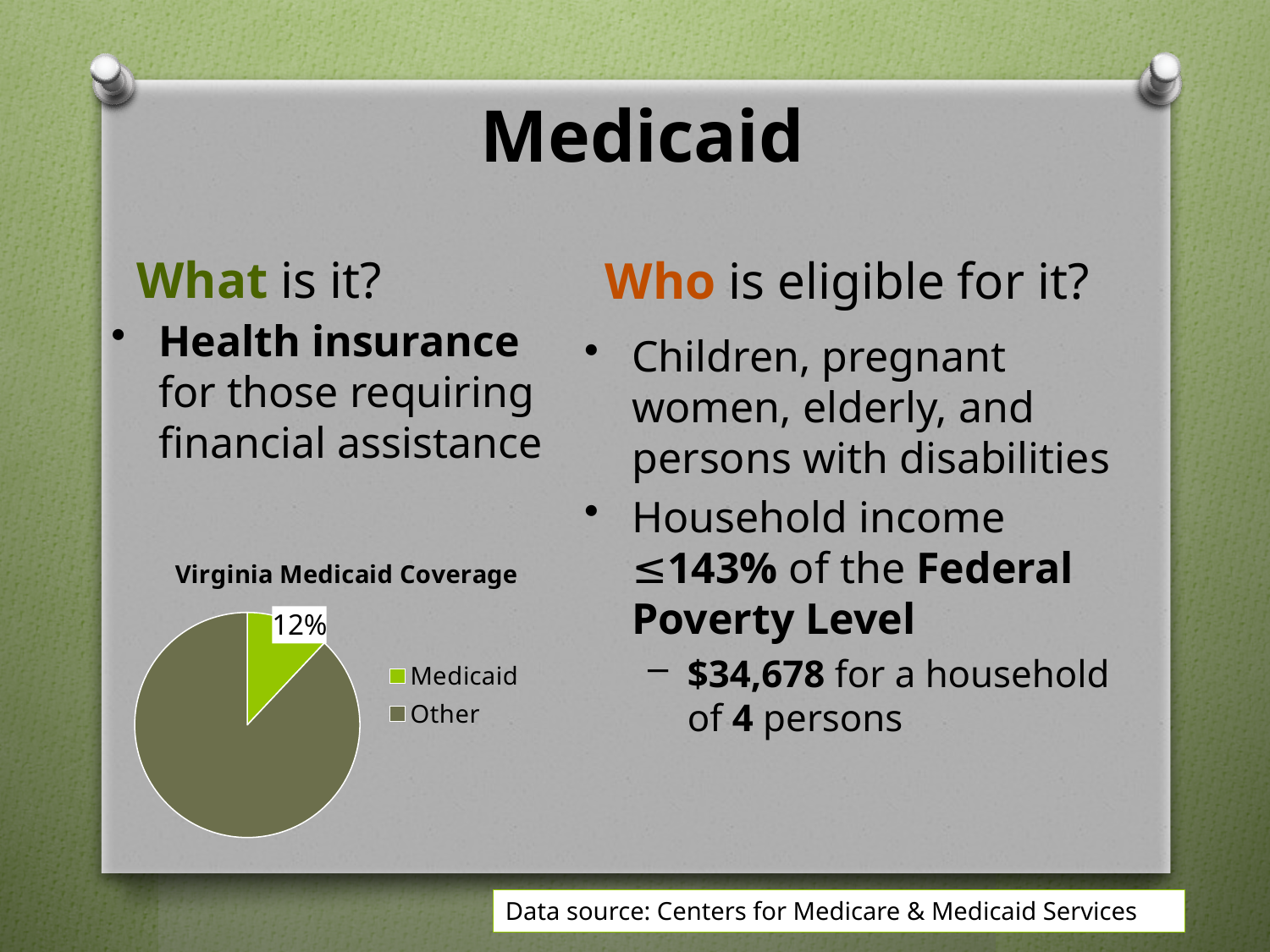
How many slices does the pie chart have? 2 Which slice of the pie is the largest? Other What is the title of the chart? Virginia Medicaid Coverage What colour is the Medicaid slice in the pie chart? light green What kind of chart is shown on the slide? pie chart Which slice of the pie is the smallest? Medicaid What share of the pie does the Medicaid slice represent? 12% How many entries does the chart legend list? 2 Which is larger in the pie chart, the Medicaid slice or the Other slice? Other Is the Medicaid slice more or less than half of the pie? less